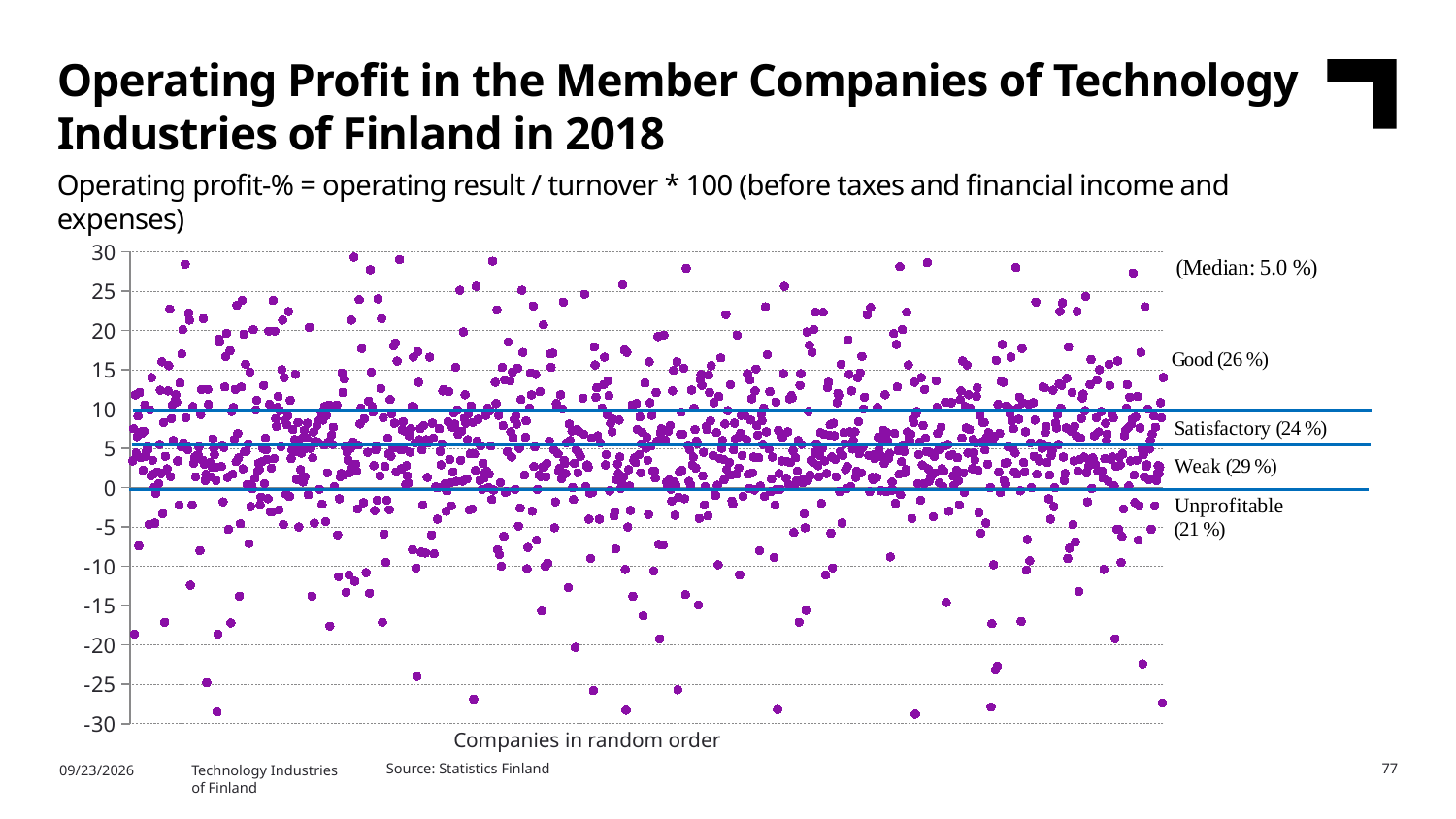
What is the median operating profit-% shown on the chart? 5.0 % Which profitability category has the largest share of companies? Weak How many profitability categories are labelled on the chart? 4 What is the label of the x axis? Companies in random order What share of companies falls into the "Satisfactory" category? 24 % How many percentage points larger is the "Weak" share than the "Unprofitable" share? 8 Which profitability category has the smallest share of companies? Unprofitable Which category has a larger share of companies, "Good" or "Satisfactory"? Good What share of companies falls into the "Good" category? 26 % What share of companies falls into the "Weak" category? 29 % What kind of chart is shown on the slide? Scatter chart What share of companies falls into the "Unprofitable" category? 21 %